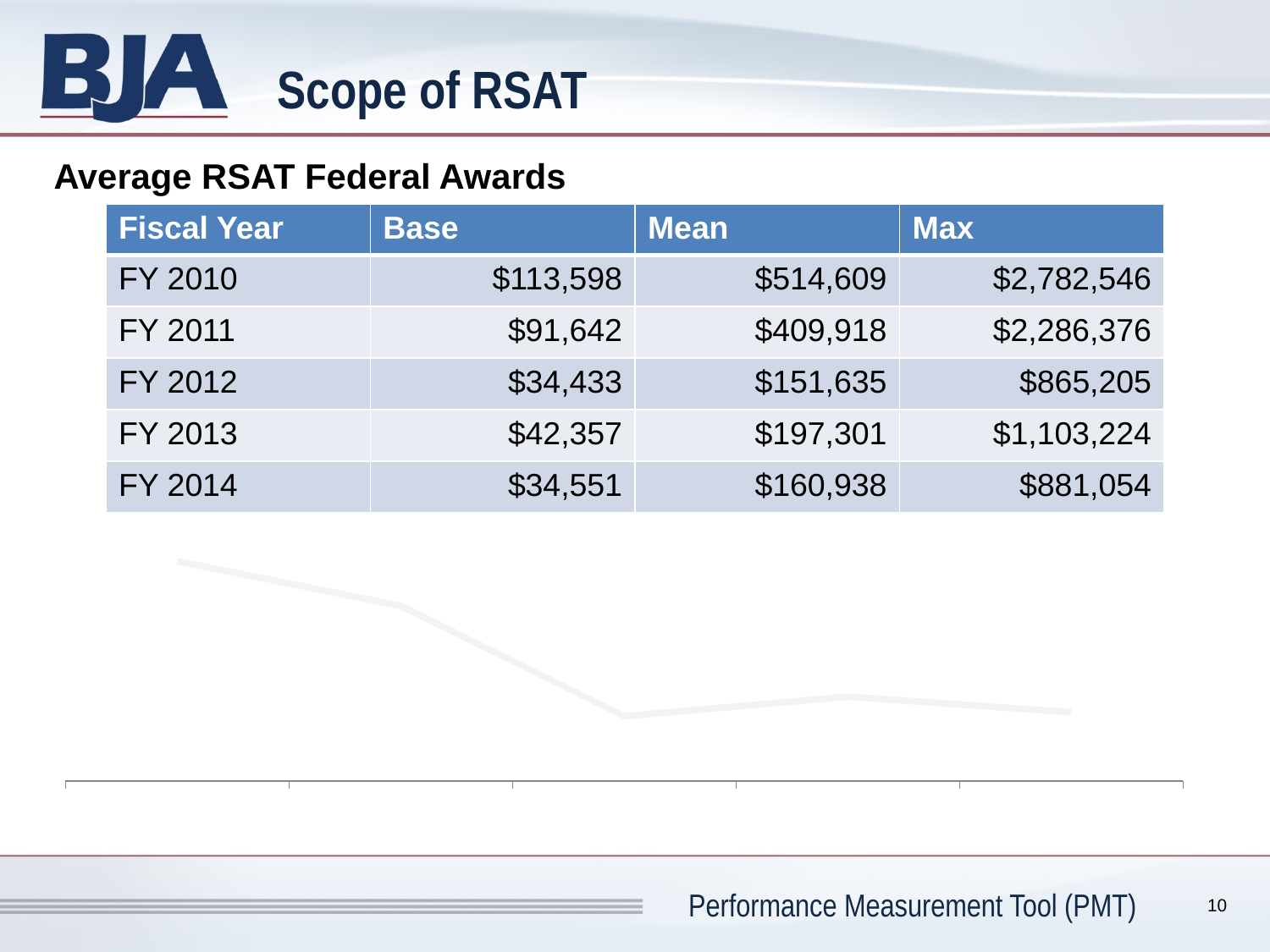
What kind of chart is shown below the table on the slide? line chart In the line chart below the table, do the values overall rise or fall from left to right? fall How many lines are plotted in the chart below the table? 1 How many data points are plotted on the line in the chart below the table? 5